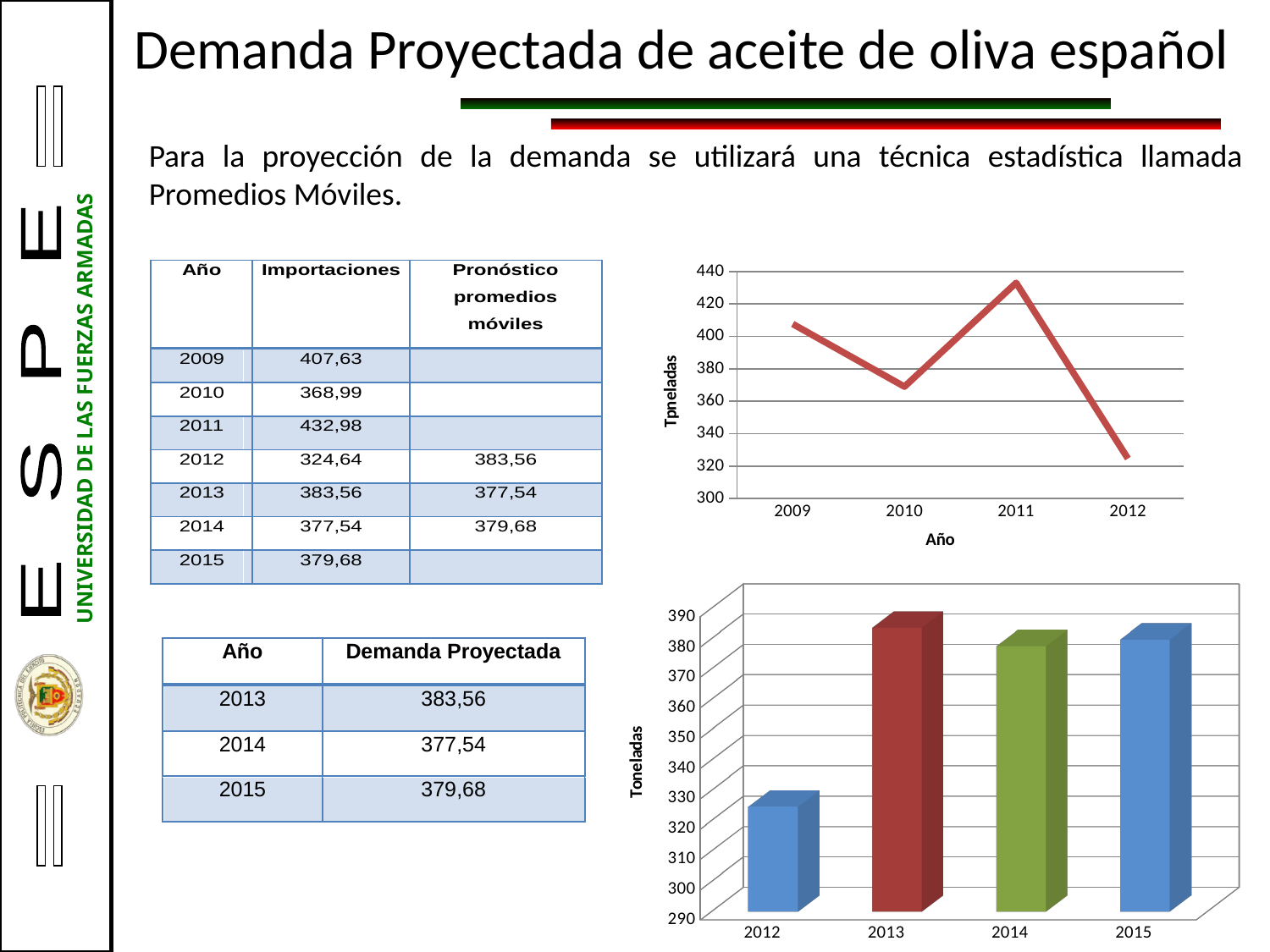
In the bar chart at the bottom right, which year has the lowest bar? 2012 How many years are plotted in the line chart at the top right? 4 What kind of chart is the chart at the top right of the slide? line chart In the line chart at the top right, is the value for 2010 greater or less than 380? less What kind of chart is the chart at the bottom right of the slide? bar chart In the bar chart at the bottom right, is the value for 2012 greater or less than 330? less In the line chart at the top right, is the value for 2011 greater or less than 420? greater In the bar chart at the bottom right, which year has the tallest bar? 2013 In the line chart at the top right, does the line rise or fall from 2011 to 2012? fall In the line chart at the top right, which year has the lowest value? 2012 What is the y-axis title of the bar chart at the bottom right? Toneladas In the line chart at the top right, which year has the highest value? 2011